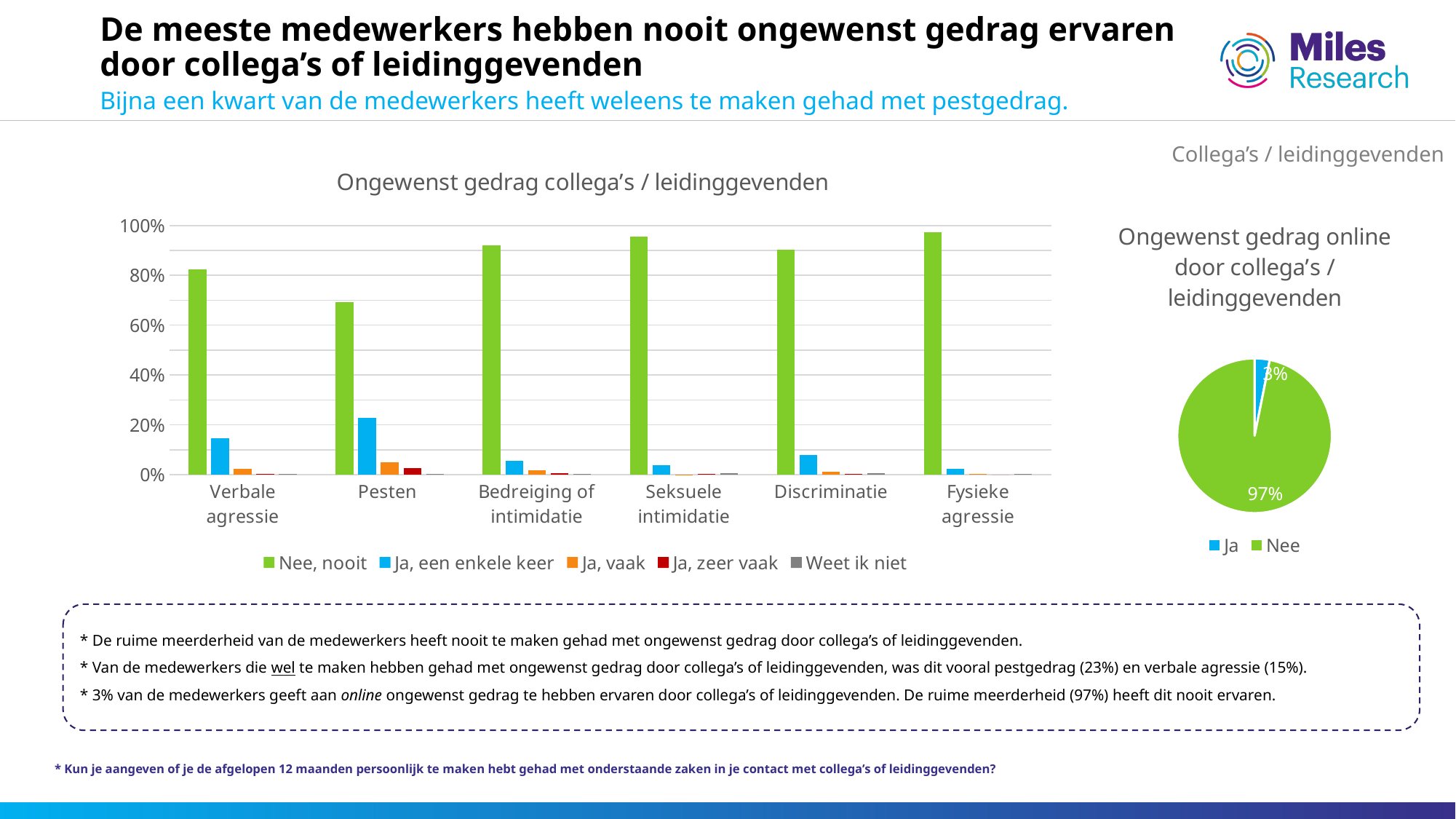
In the bar chart 'Ongewenst gedrag collega's / leidinggevenden', is the 'Nee, nooit' value for Pesten greater or less than 80%? less In the pie chart 'Ongewenst gedrag online door collega's / leidinggevenden', which slice is the largest? Nee In the bar chart 'Ongewenst gedrag collega's / leidinggevenden', how many categories are shown on the x axis? 6 What kind of chart is 'Ongewenst gedrag online door collega's / leidinggevenden'? Pie chart In the bar chart 'Ongewenst gedrag collega's / leidinggevenden', how many series does the legend list? 5 In the pie chart 'Ongewenst gedrag online door collega's / leidinggevenden', what percentage is shown for 'Nee'? 97% In the pie chart 'Ongewenst gedrag online door collega's / leidinggevenden', what percentage is shown for 'Ja'? 3% In the bar chart 'Ongewenst gedrag collega's / leidinggevenden', for which category is the 'Nee, nooit' bar the lowest? Pesten In the pie chart 'Ongewenst gedrag online door collega's / leidinggevenden', what is the difference in percentage points between 'Nee' and 'Ja'? 94 percentage points In the pie chart 'Ongewenst gedrag online door collega's / leidinggevenden', how many entries does the legend list? 2 In the bar chart 'Ongewenst gedrag collega's / leidinggevenden', for which category is the 'Ja, een enkele keer' bar the highest? Pesten What kind of chart is 'Ongewenst gedrag collega's / leidinggevenden'? Bar chart